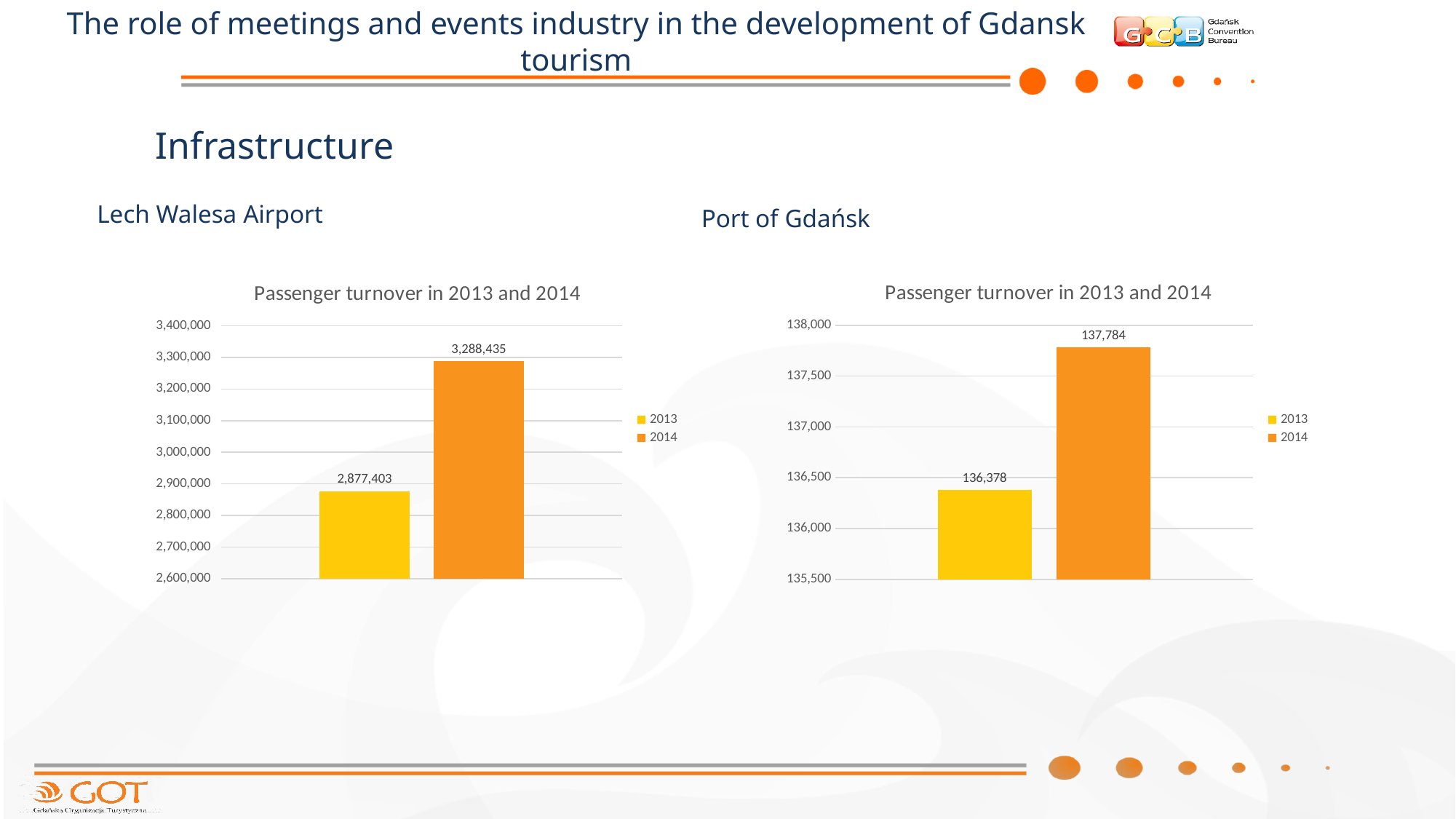
What type of chart is used for the Lech Walesa Airport passenger turnover (left)? Bar chart In the Port of Gdańsk chart (right), which year had the lower passenger turnover? 2013 In the Port of Gdańsk chart (right), what is the difference between the 2014 and 2013 passenger turnover? 1,406 In the Lech Walesa Airport chart (left), which year had the higher passenger turnover? 2014 In the Lech Walesa Airport chart (left), is the 2013 value greater or less than 3,000,000? less In the Port of Gdańsk chart (right), what was the passenger turnover in 2014? 137,784 In the Port of Gdańsk chart (right), is the 2014 value greater or less than 137,500? greater In the Lech Walesa Airport chart (left), what was the passenger turnover in 2014? 3,288,435 In the Port of Gdańsk chart (right), what was the passenger turnover in 2013? 136,378 In the Lech Walesa Airport chart (left), what was the passenger turnover in 2013? 2,877,403 In the Lech Walesa Airport chart (left), by how much did passenger turnover increase from 2013 to 2014? 411,032 How many series does the legend of the Port of Gdańsk chart (right) list? 2